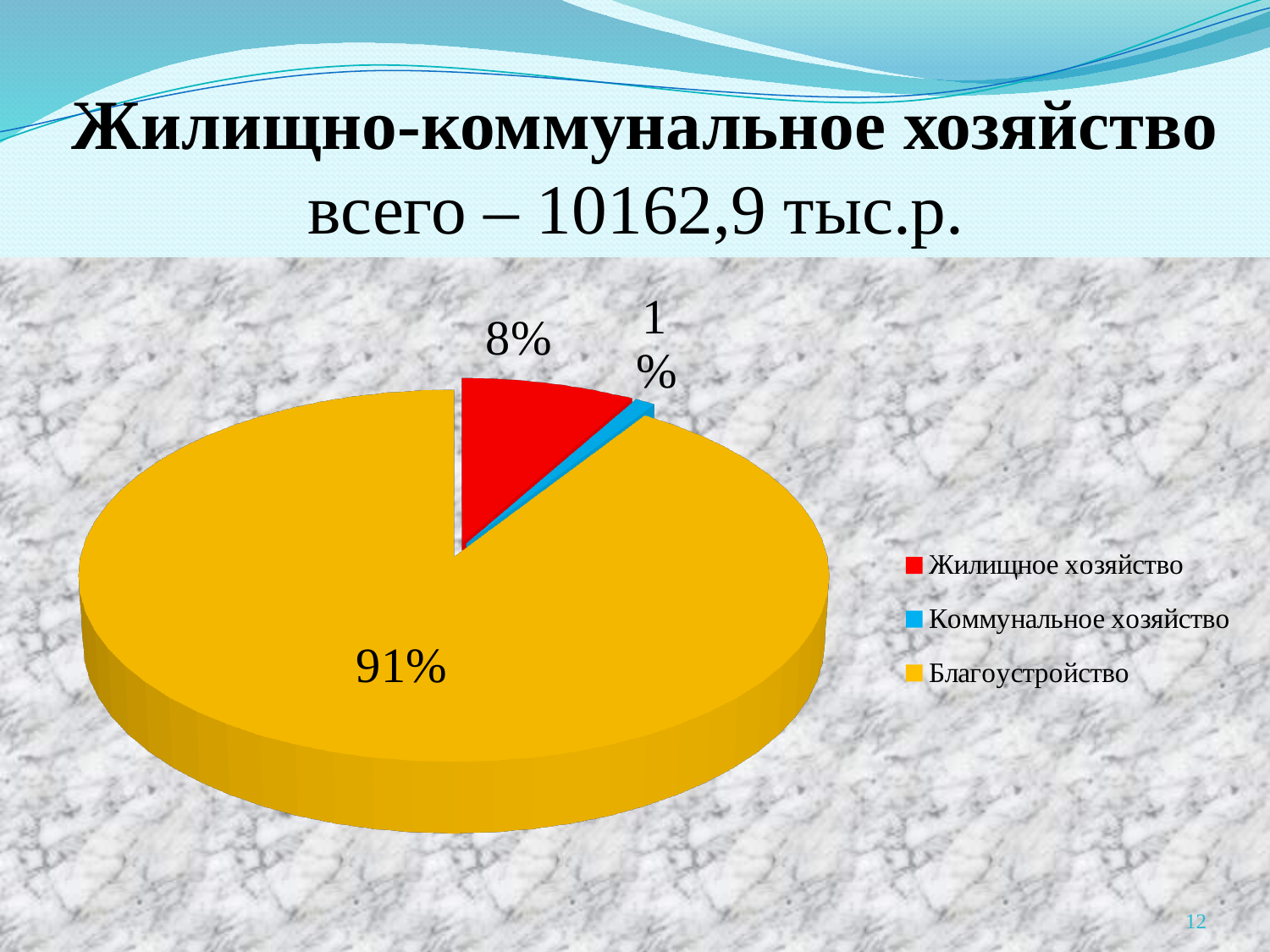
Which is larger, the slice for Жилищное хозяйство or the slice for Коммунальное хозяйство? Жилищное хозяйство How many entries does the legend list? 3 How many categories does the pie chart show? 3 What colour is the slice for Коммунальное хозяйство? blue What share of the pie does Благоустройство have? 91% What total amount is stated in the slide title? 10162,9 тыс.р. Which category has the smallest slice of the pie? Коммунальное хозяйство What is the difference in percentage points between the Благоустройство slice and the Жилищное хозяйство slice? 83 What share of the pie does Жилищное хозяйство have? 8% What share of the pie does Коммунальное хозяйство have? 1% What kind of chart is shown on the slide? pie chart Which category has the largest slice of the pie? Благоустройство